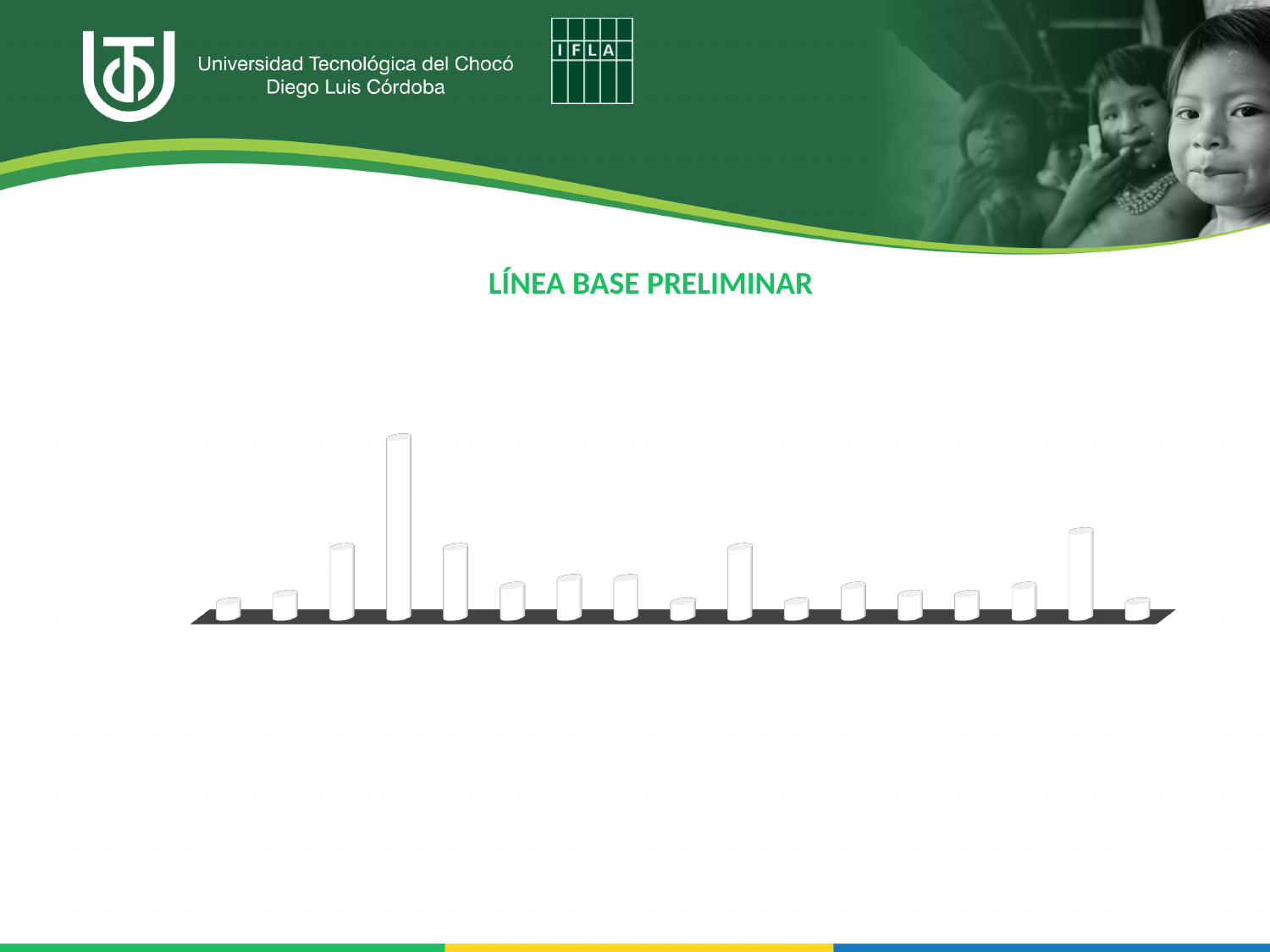
Which is taller, the 4th bar from the left or the 16th bar from the left? the 4th bar How many bars does the chart contain? 17 Which is taller, the 2nd bar from the left or the 3rd bar from the left? the 3rd bar What is the title shown above the chart? LÍNEA BASE PRELIMINAR What kind of chart is shown on the slide? bar chart Counting from the left, which bar is the second tallest in the chart? the 16th bar Counting from the left, which bar is the tallest in the chart? the 4th bar What colour are the bars in the chart? white